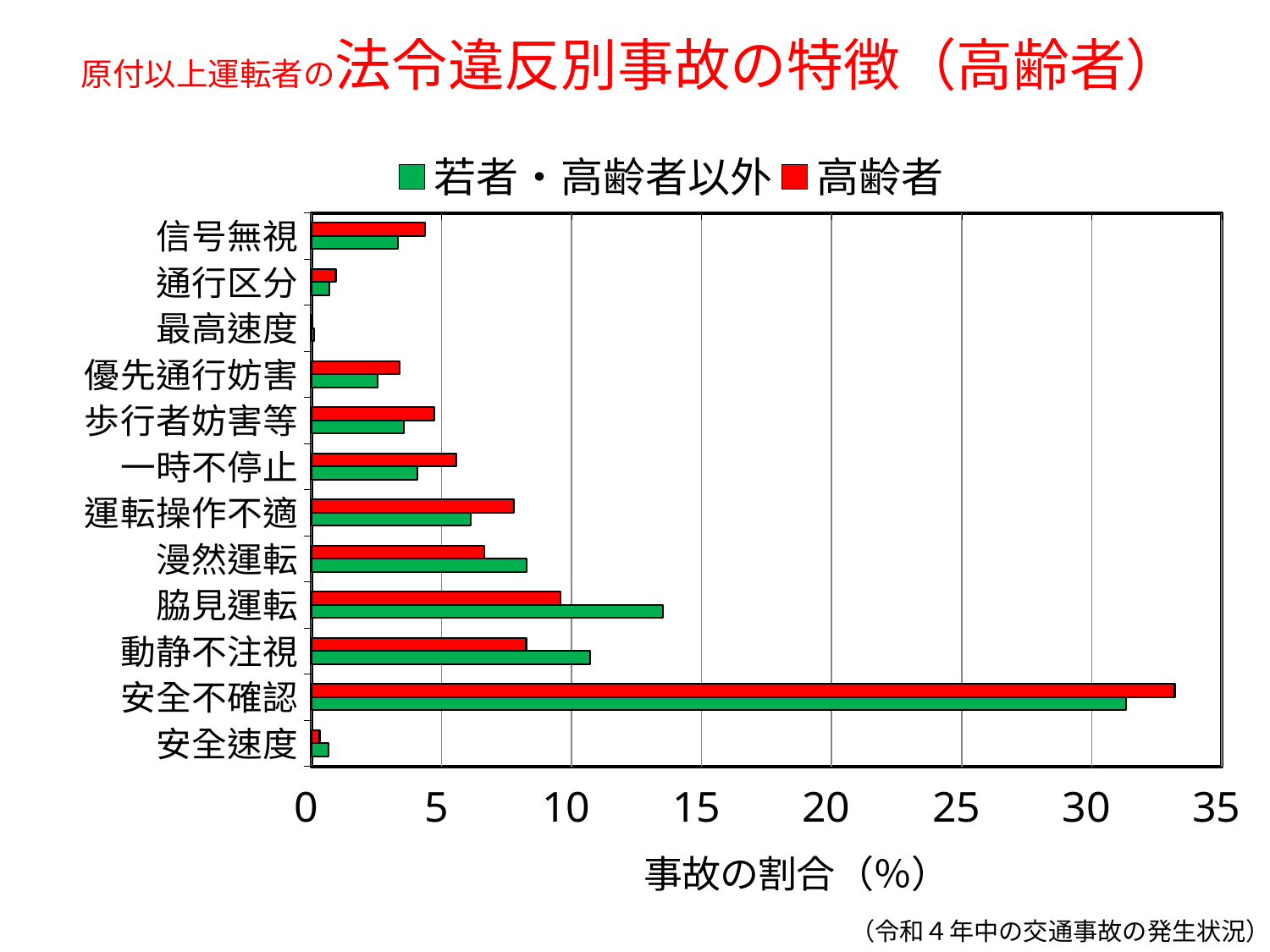
What is the x-axis label of the chart? 事故の割合（%） Is the 若者・高齢者以外 value for 脇見運転 greater or less than 10? greater Is the 高齢者 value for 動静不注視 greater or less than 10? less Which category has the lowest value for 若者・高齢者以外? 最高速度 For 運転操作不適, which series has the larger value, 若者・高齢者以外 or 高齢者? 高齢者 Is the 高齢者 value for 一時不停止 greater or less than 5? greater What kind of chart is shown on the slide? bar chart How many series does the legend list? 2 How many violation categories are plotted on the y axis? 12 For 脇見運転, which series has the larger value, 若者・高齢者以外 or 高齢者? 若者・高齢者以外 Which category has the highest value for 高齢者? 安全不確認